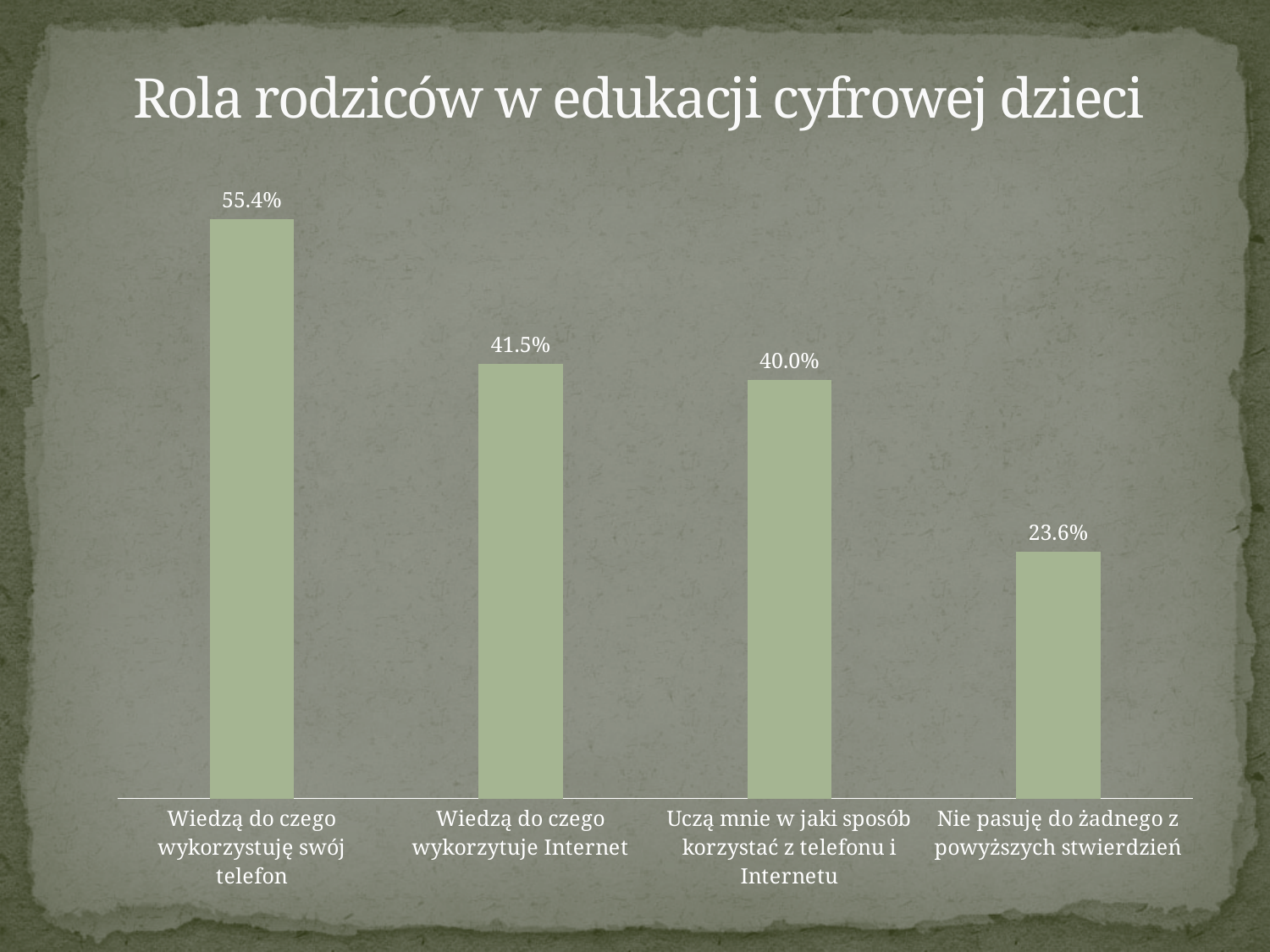
Which category has the highest value? Wiedzą do czego wykorzystuję swój telefon What is the value for "Uczą mnie w jaki sposób korzystać z telefonu i Internetu"? 40.0% What is the value for "Nie pasuję do żadnego z powyższych stwierdzień"? 23.6% What is the value for "Wiedzą do czego wykorzytuje Internet"? 41.5% What kind of chart is shown on the slide? Bar chart Which is larger: the value for "Wiedzą do czego wykorzytuje Internet" or for "Nie pasuję do żadnego z powyższych stwierdzień"? Wiedzą do czego wykorzytuje Internet What is the difference between the values for "Wiedzą do czego wykorzytuje Internet" and "Uczą mnie w jaki sposób korzystać z telefonu i Internetu"? 1.5% Which category has the lowest value? Nie pasuję do żadnego z powyższych stwierdzień How many categories are shown in the chart? 4 What is the value for "Wiedzą do czego wykorzystuję swój telefon"? 55.4% What is the difference between the values for "Wiedzą do czego wykorzystuję swój telefon" and "Nie pasuję do żadnego z powyższych stwierdzień"? 31.8% What is the title of the slide? Rola rodziców w edukacji cyfrowej dzieci